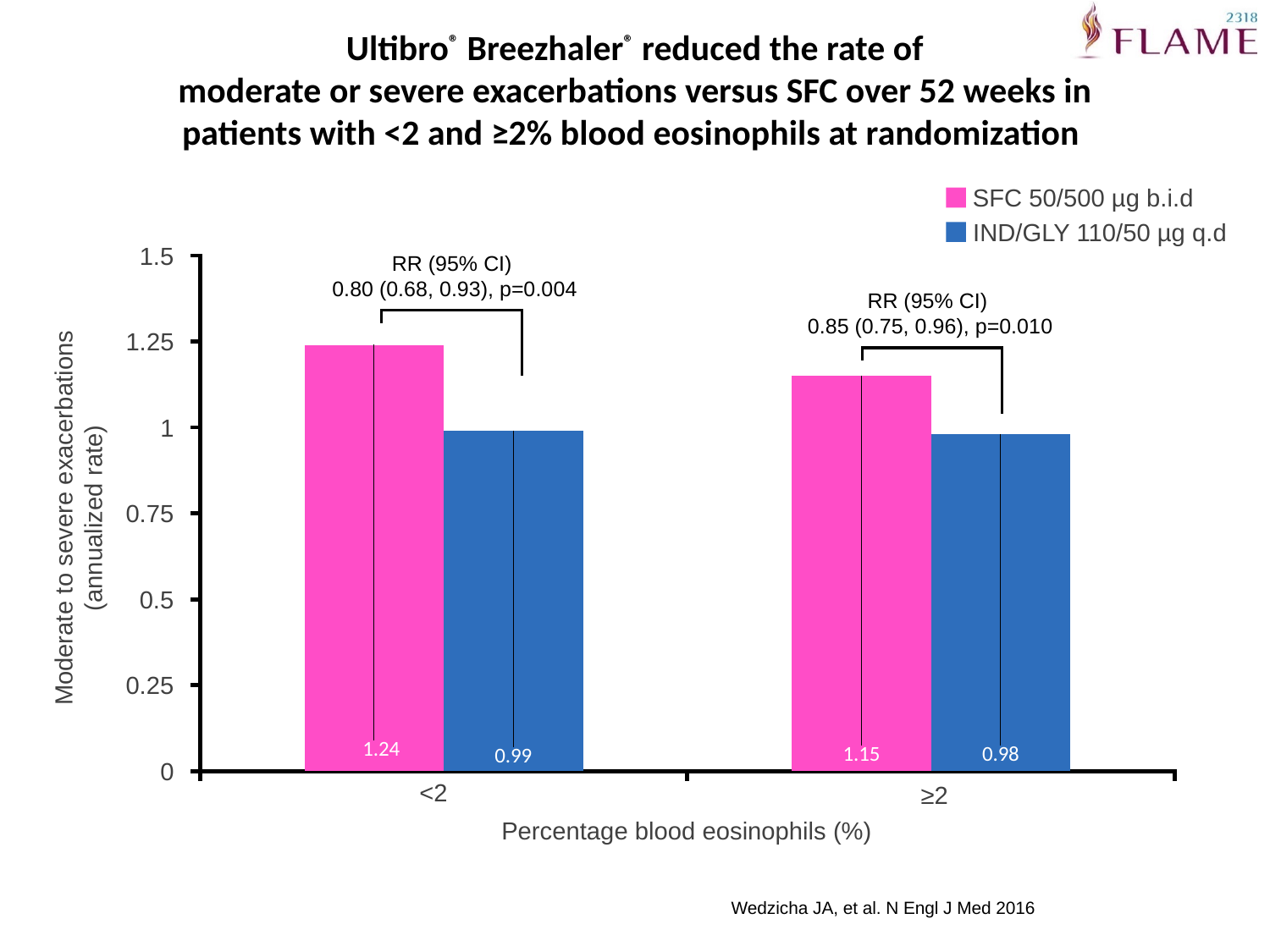
What is the annualized rate of moderate to severe exacerbations for SFC 50/500 µg b.i.d in the <2% blood eosinophils group? 1.24 What is the annualized rate of moderate to severe exacerbations for IND/GLY 110/50 µg q.d in the ≥2% blood eosinophils group? 0.98 How many series does the legend list? 2 In the ≥2% blood eosinophils group, which treatment has the higher annualized exacerbation rate, SFC or IND/GLY? SFC 50/500 µg b.i.d Which bar shows the highest annualized exacerbation rate on the chart? SFC 50/500 µg b.i.d, <2 What kind of chart is shown on the slide? Bar chart What is the annualized exacerbation rate for IND/GLY 110/50 µg q.d in the <2% blood eosinophils group? 0.99 What is the difference in annualized exacerbation rate between SFC and IND/GLY in the <2% blood eosinophils group? 0.25 What is the RR (95% CI) shown above the bars for the <2% blood eosinophils group? 0.80 (0.68, 0.93), p=0.004 Which bar shows the lowest annualized exacerbation rate on the chart? IND/GLY 110/50 µg q.d, ≥2 What is the difference in annualized exacerbation rate between SFC and IND/GLY in the ≥2% blood eosinophils group? 0.17 What is the annualized exacerbation rate for SFC 50/500 µg b.i.d in the ≥2% blood eosinophils group? 1.15